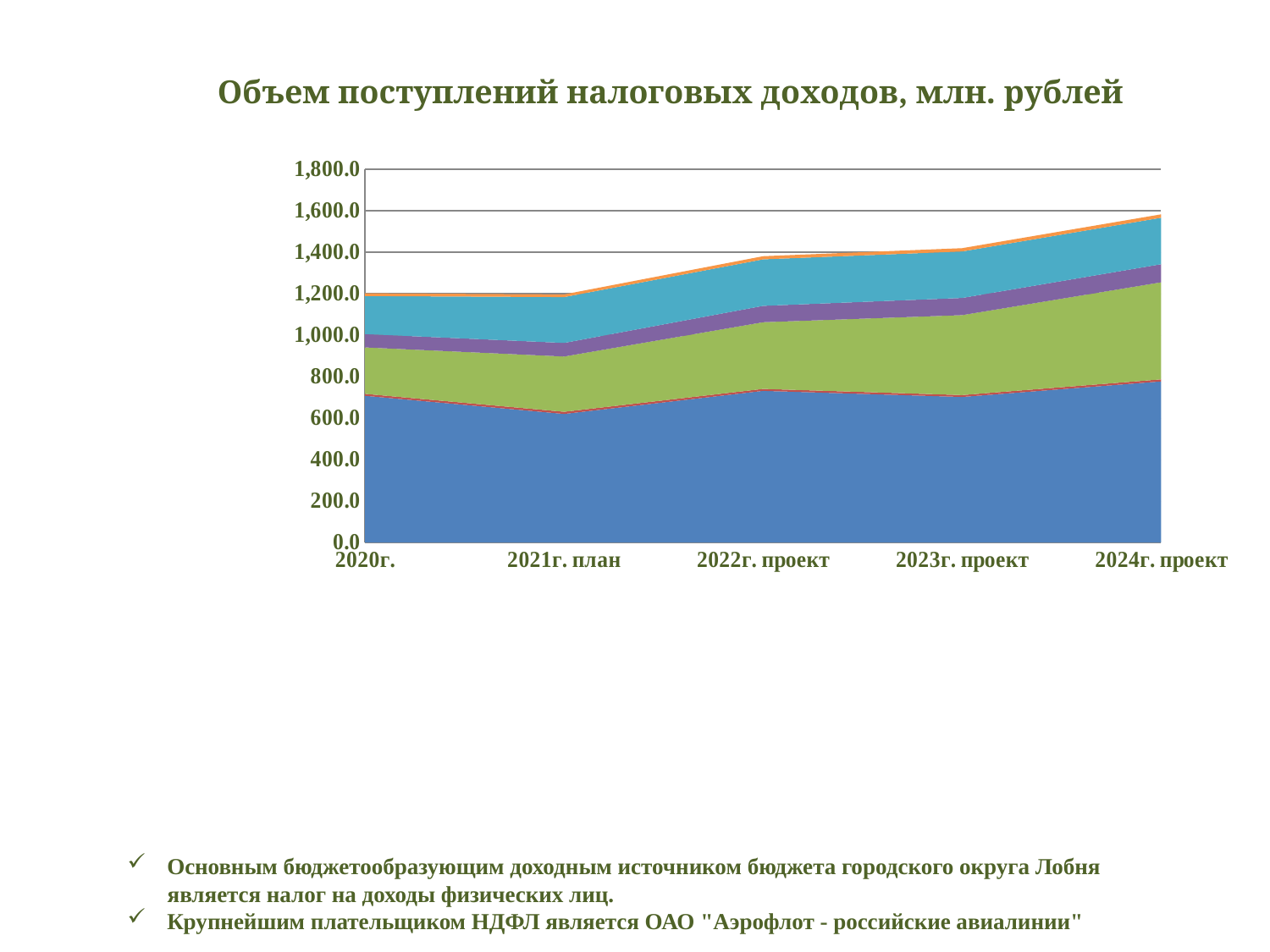
What is the title of the chart? Объем поступлений налоговых доходов, млн. рублей Is the total stacked value for 2020г. greater or less than 1,400? less Is the value of the bottom (blue) series for 2020г. greater or less than 600? greater Is the total stacked value larger for 2024г. проект or for 2022г. проект? 2024г. проект In which category is the bottom (blue) series at its lowest? 2021г. план What kind of chart is shown on the slide? stacked area chart What is the highest value shown on the y axis of the chart? 1,800.0 Does the total stacked value rise or fall from 2021г. план to 2024г. проект? rise Which category has the highest total stacked value? 2024г. проект Is the total stacked value for 2024г. проект greater or less than 1,400? greater How many categories are shown along the x axis of the chart? 5